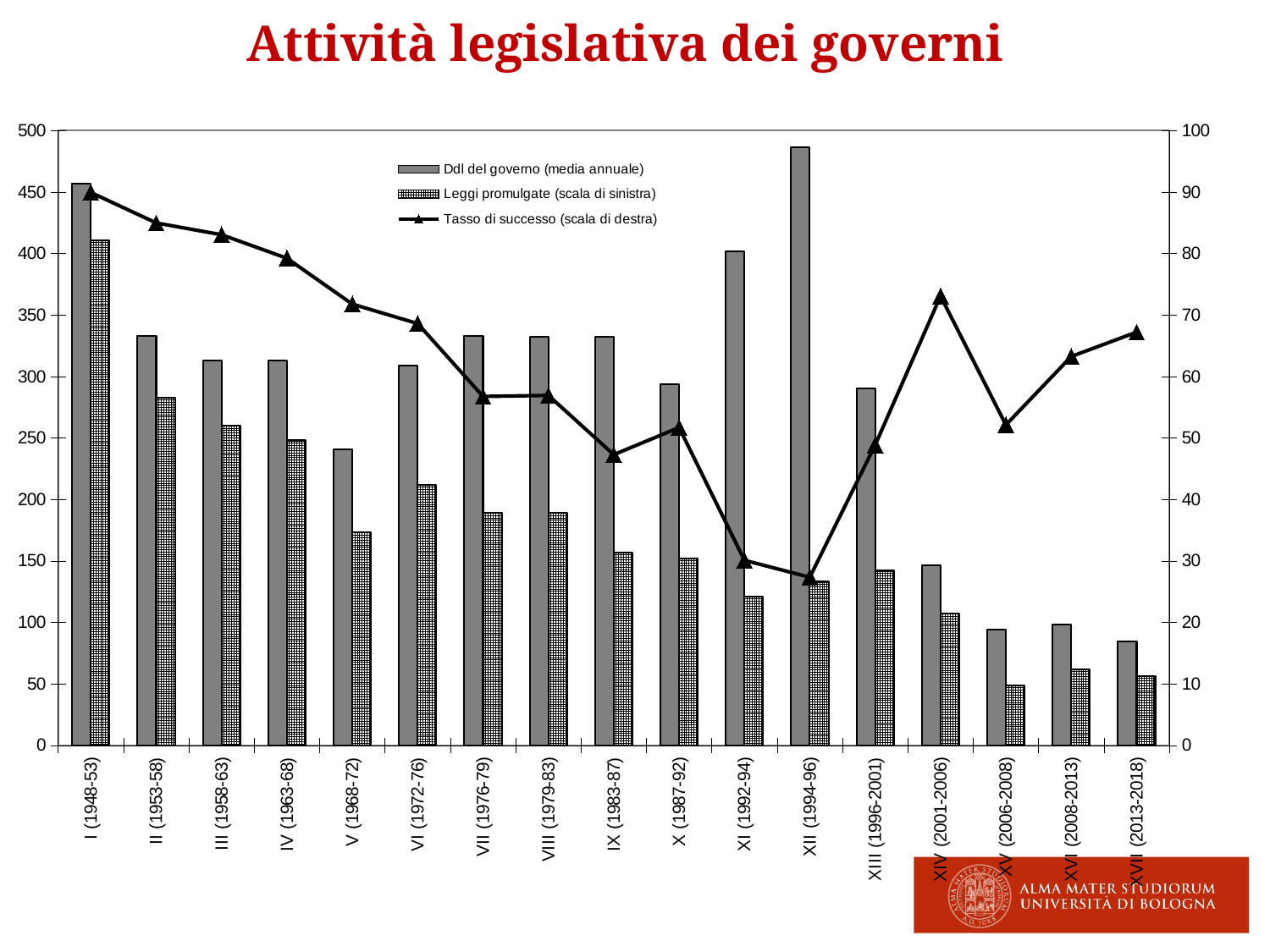
Is the value of Ddl del governo for XII (1994-96) greater or less than 450? greater Is the Tasso di successo for XIV (2001-2006) greater or less than 60 on the right-hand scale? greater What kind of chart is this? Combined bar and line chart Which government has the highest value for Leggi promulgate? I (1948-53) Does the Tasso di successo rise or fall from I (1948-53) to XII (1994-96)? fall Which government has the lowest Tasso di successo? XII (1994-96) How many governments (categories) are shown on the x axis? 17 Which is larger, the Leggi promulgate value for II (1953-58) or for III (1958-63)? II (1953-58) Which government has the highest value for Ddl del governo (media annuale)? XII (1994-96) Is the value of Leggi promulgate for XV (2006-2008) greater or less than 100? less Which government has the lowest value for Ddl del governo (media annuale)? XVII (2013-2018) How many series does the legend list? 3